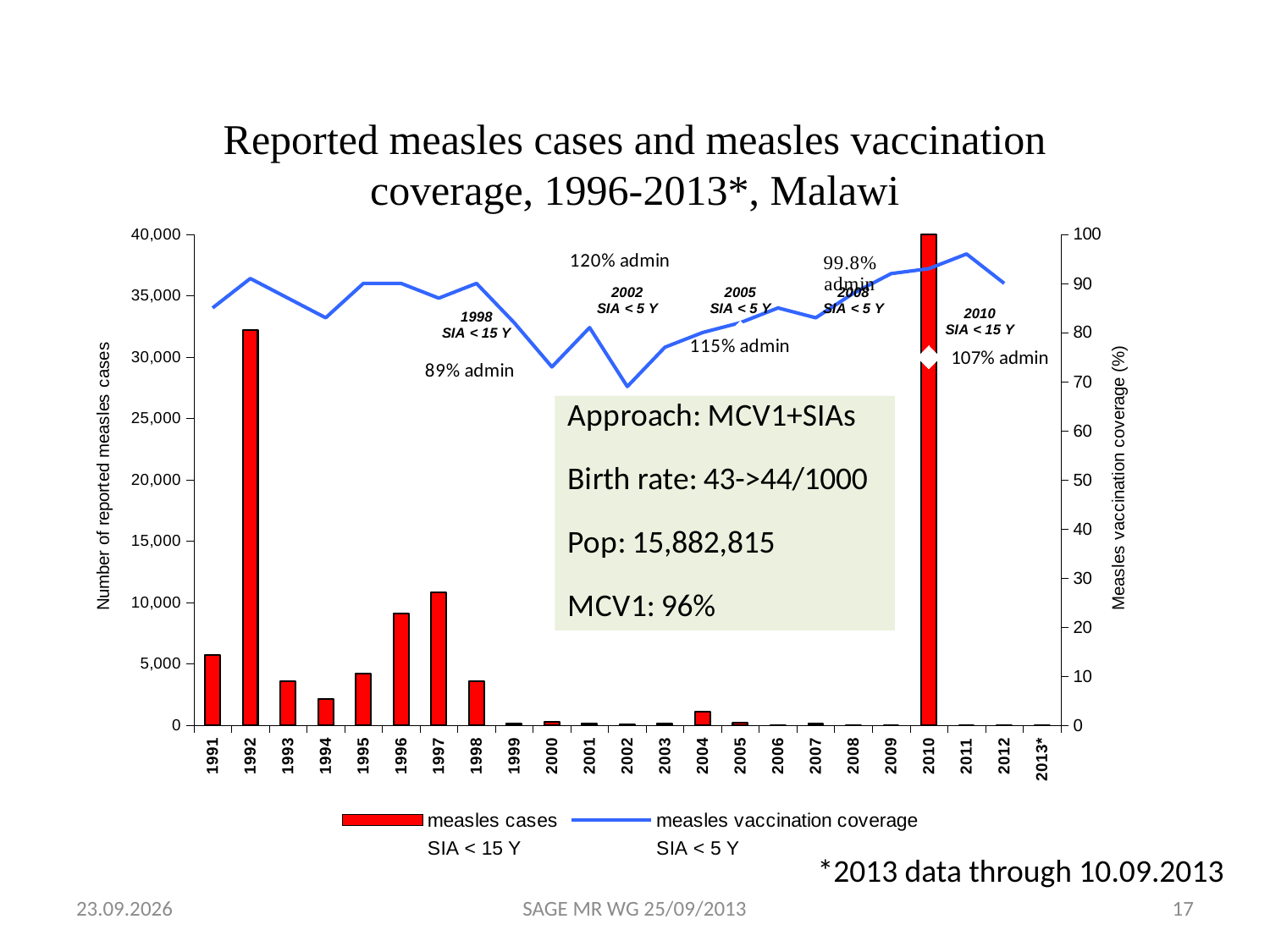
Which year has the highest bar for measles cases? 2010 What kind of chart is shown on the slide? A combined bar and line chart What is the label of the right-hand vertical axis? Measles vaccination coverage (%) How many years are shown along the x axis of the chart? 23 Is the number of measles cases in 1992 greater or less than 30,000? greater How many series does the chart legend list? 4 Which year had more measles cases, 1996 or 1997? 1997 Is the measles vaccination coverage in 2002 greater or less than 80%? less Which year had more measles cases, 1991 or 1995? 1991 Is the number of measles cases in 1997 greater or less than 10,000? greater In which year is the measles vaccination coverage line at its lowest? 2002